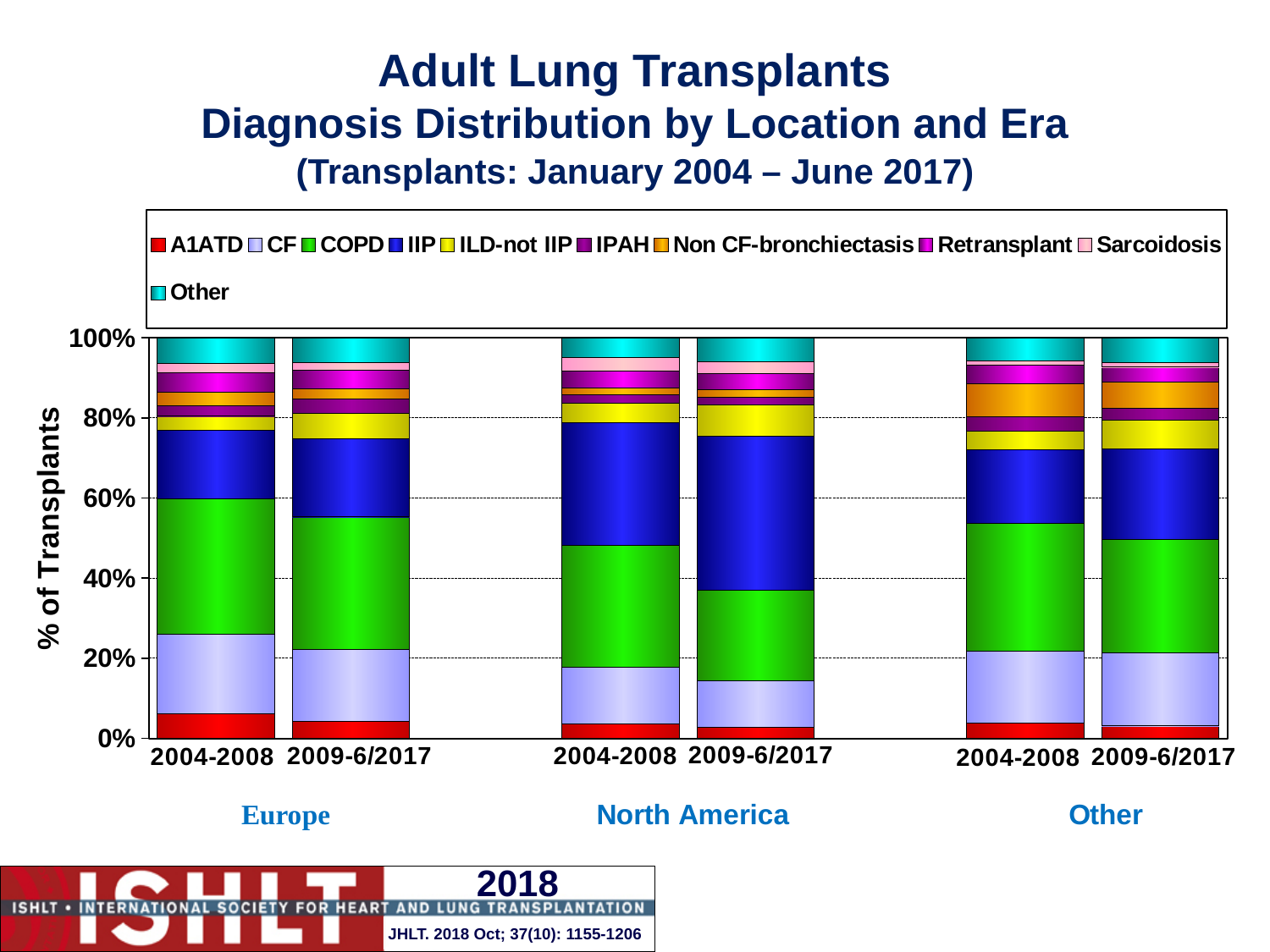
In the Europe 2004-2008 bar, is the COPD segment greater or less than 20%? greater How many series does the legend list? 10 Is the COPD segment larger in the Europe 2004-2008 bar or the North America 2009-6/2017 bar? Europe 2004-2008 How many locations are shown along the x axis? 3 Which bar has the largest IIP segment? North America 2009-6/2017 In the Other 2004-2008 bar, is the CF segment greater or less than 30%? less What kind of chart is shown on the slide? Stacked bar chart What is the label on the y axis? % of Transplants What is the first entry in the legend? A1ATD In North America, does the IIP share rise or fall from 2004-2008 to 2009-6/2017? rise In the North America 2009-6/2017 bar, is the IIP segment greater or less than 30%? greater How many bars are plotted in the chart? 6